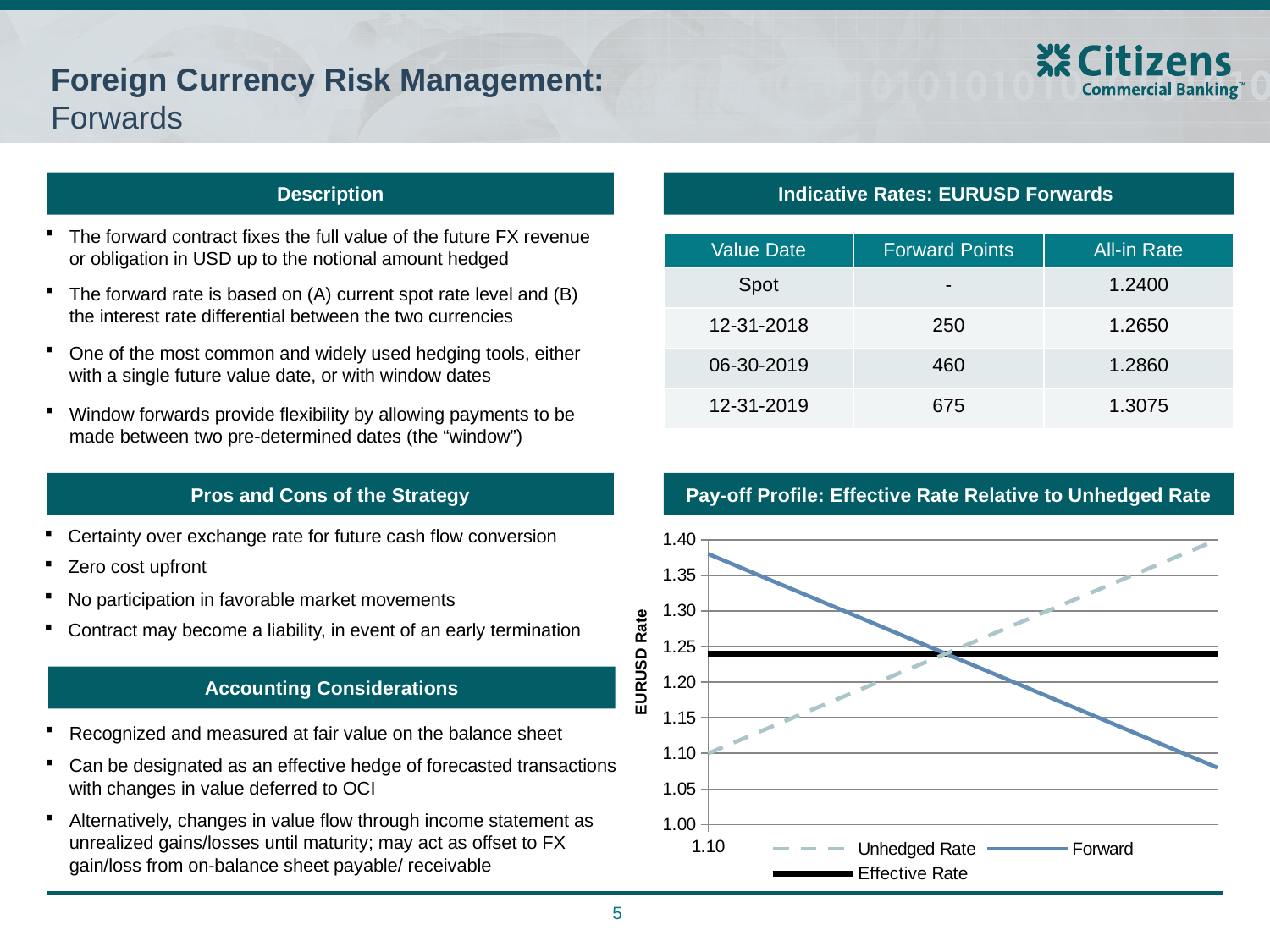
In the Pay-off Profile chart, does the Effective Rate line rise, fall, or stay flat across the x axis? Stay flat In the Pay-off Profile chart, is the Effective Rate line greater or less than 1.20? greater In the Pay-off Profile chart, at the far right of the chart, which is higher: the Forward line or the Unhedged Rate line? Unhedged Rate In the Pay-off Profile chart, does the Unhedged Rate line rise or fall from left to right? Rise In the Pay-off Profile chart, does the Forward line rise or fall from left to right? Fall What is the label on the vertical axis of the Pay-off Profile chart? EURUSD Rate In the Pay-off Profile chart, at the far left of the chart, which is higher: the Forward line or the Unhedged Rate line? Forward In the Pay-off Profile chart, is the Forward line at the far right of the chart greater or less than 1.10? less In the Pay-off Profile chart, is the Forward line at the far left of the chart greater or less than 1.35? greater How many series does the legend of the Pay-off Profile chart list? 3 What kind of chart is shown under "Pay-off Profile: Effective Rate Relative to Unhedged Rate"? Line chart